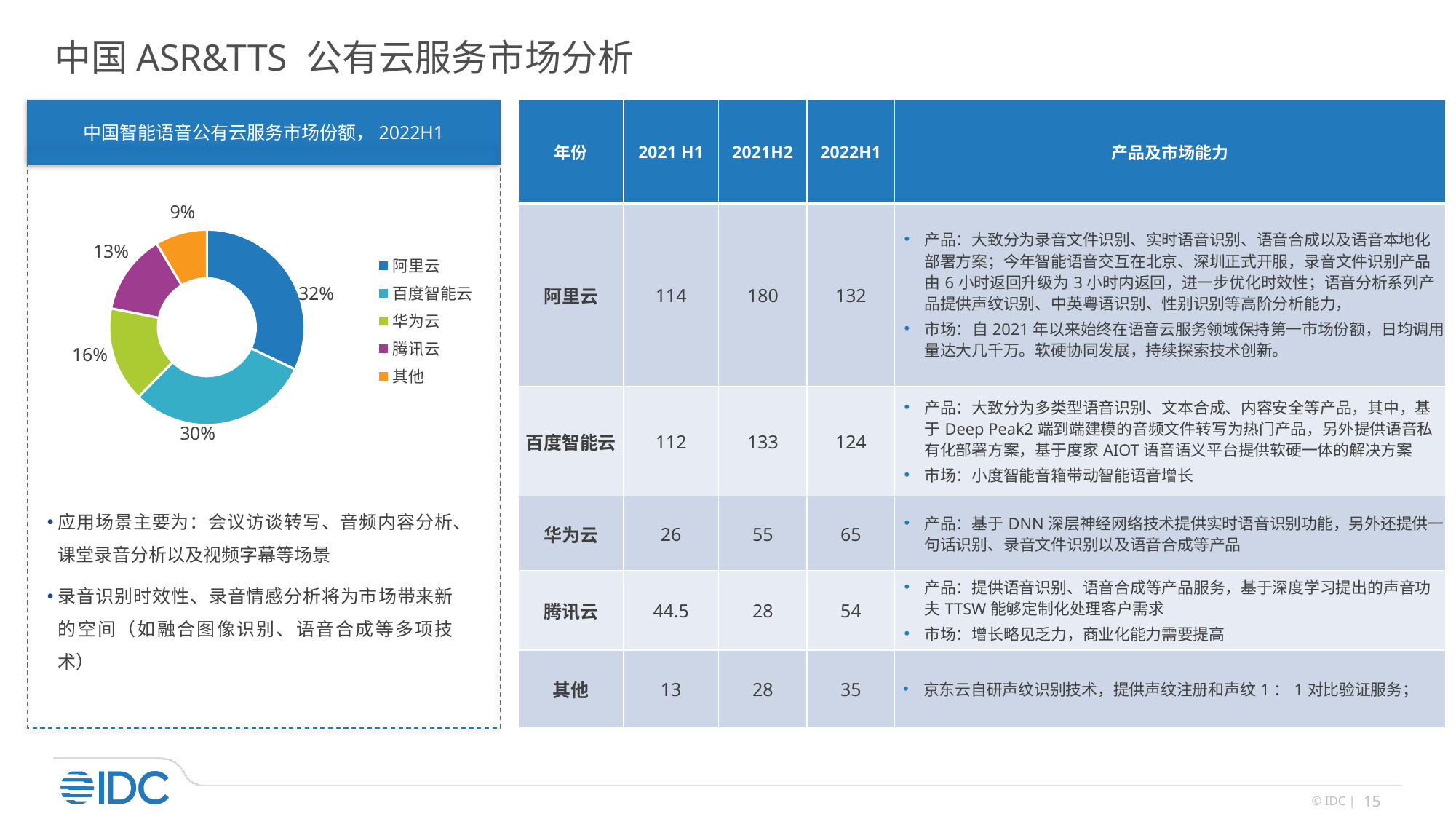
Which category has the largest share in the donut chart? 阿里云 Which category has the smallest share in the donut chart? 其他 How many categories are shown in the donut chart? 5 What is the title of the chart on the left of the slide? 中国智能语音公有云服务市场份额，2022H1 What type of chart is shown on the left of the slide? Donut (pie) chart What share of the donut chart does 阿里云 hold? 32% What is the difference in share between 阿里云 and 百度智能云 in the donut chart? 2% What share of the donut chart does 腾讯云 hold? 13% What share of the donut chart does 华为云 hold? 16% Which has a larger share in the donut chart, 华为云 or 腾讯云? 华为云 What share of the donut chart does 其他 hold? 9% What share of the donut chart does 百度智能云 hold? 30%